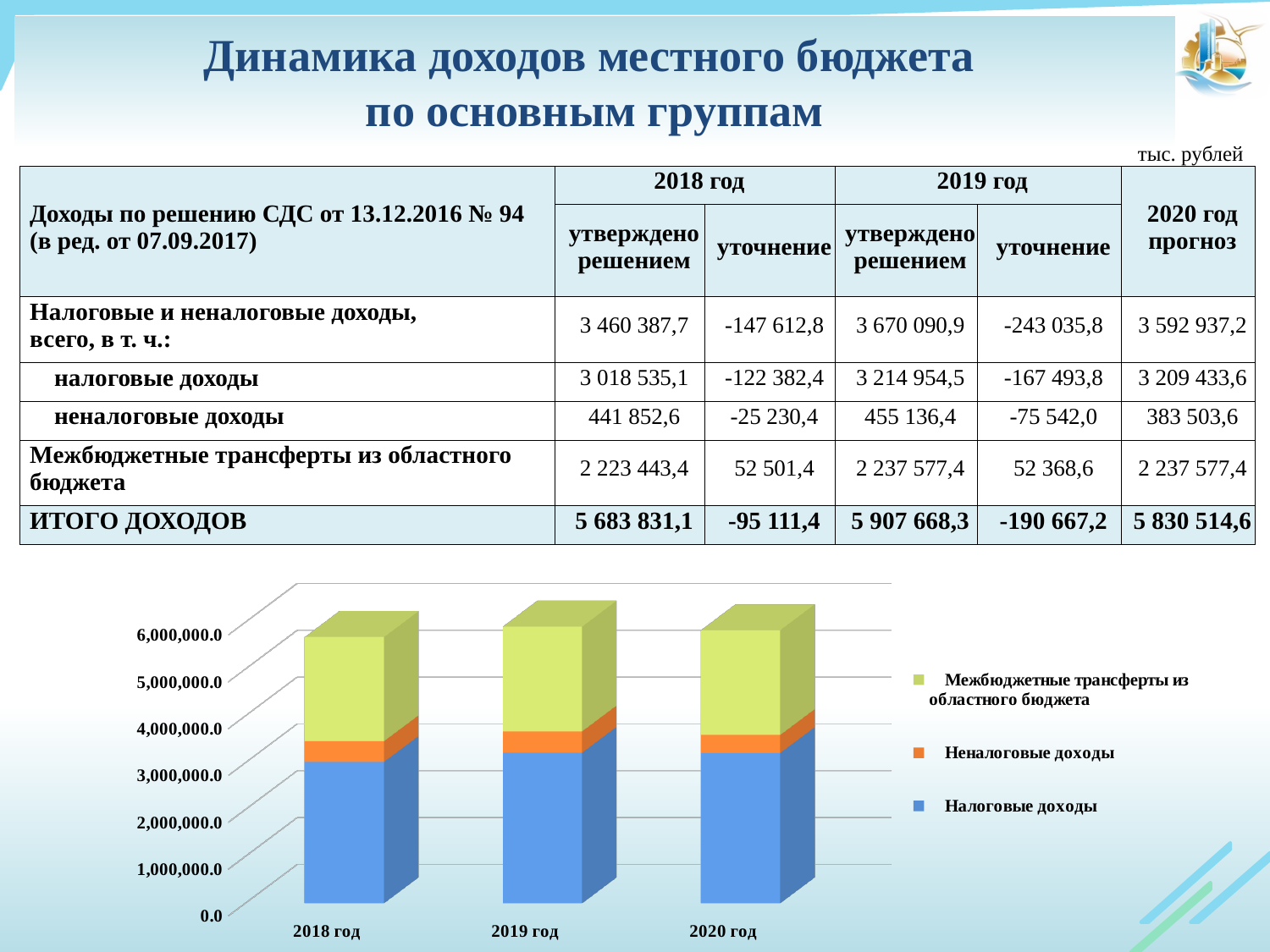
Which series is shown in blue in the chart? Налоговые доходы How many series does the chart legend list? 3 In the chart, is the value of Налоговые доходы for 2018 год greater or less than 2,000,000.0? greater In the chart for 2020 год, which is larger: Налоговые доходы or Неналоговые доходы? Налоговые доходы How many years (categories) are shown on the x axis of the chart? 3 What kind of chart is shown at the bottom of the slide? Stacked bar chart Which series is shown in orange in the chart? Неналоговые доходы In the chart for 2019 год, which is larger: Межбюджетные трансферты из областного бюджета or Неналоговые доходы? Межбюджетные трансферты из областного бюджета What is the highest value shown on the chart's vertical axis? 6,000,000.0 In the chart, is the value of Налоговые доходы for 2020 год greater or less than 4,000,000.0? less In the chart, which series has the smallest segment in every year? Неналоговые доходы In the chart, is the total stacked bar for 2018 год greater or less than 5,000,000.0? greater